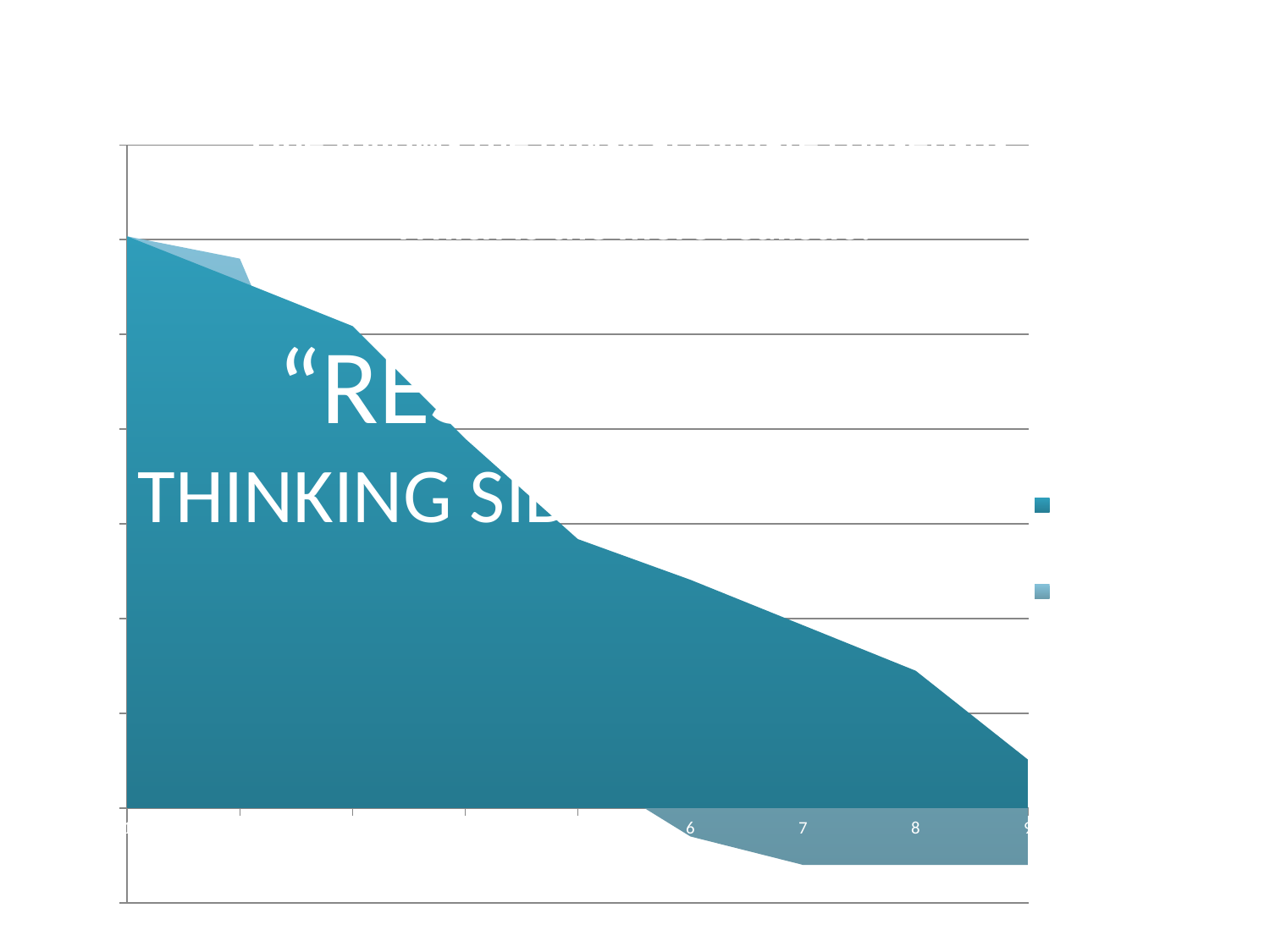
Which colour is the main, largest area series in the chart? dark blue/teal How many series does the legend list? 2 Do the values of the large dark blue series rise or fall from left to right along the x axis? fall What kind of chart is shown on the slide? area chart What is the highest x-axis label readable on the chart? 9